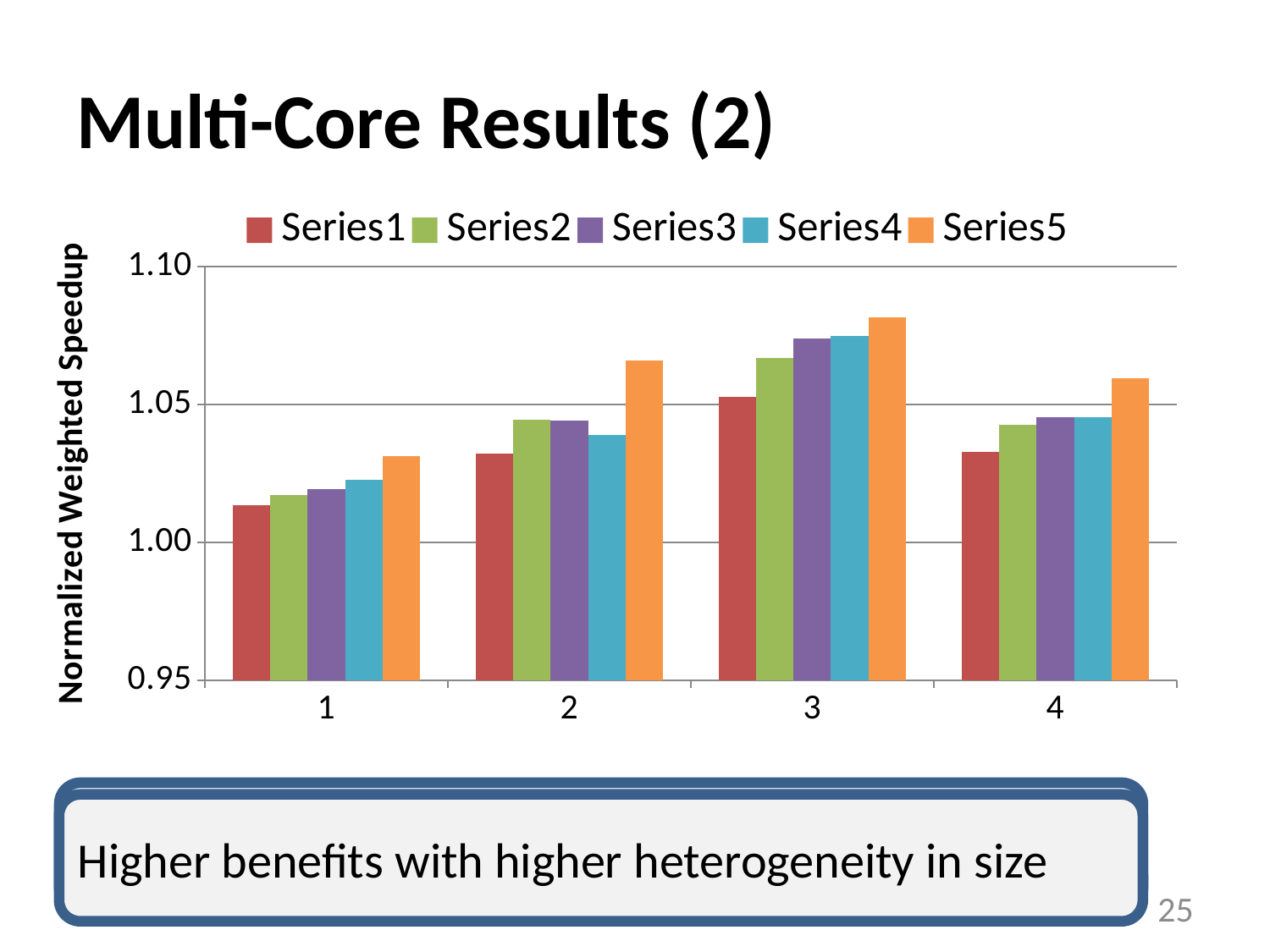
At which category does Series1 have its lowest value? 1 Is the value for Series5 at category 3 greater or less than 1.05? greater Is the value for Series4 at category 2 greater or less than 1.05? less What kind of chart is shown on the slide? bar chart How many categories are shown on the x axis? 4 How many series does the legend list? 5 Which series has the highest value at category 3? Series5 Is the value for Series1 at category 1 greater or less than 1.05? less Which series is shown in orange in the legend? Series5 Which is larger: the Series1 value at category 2 or at category 3? category 3 What is the y-axis title of the chart? Normalized Weighted Speedup